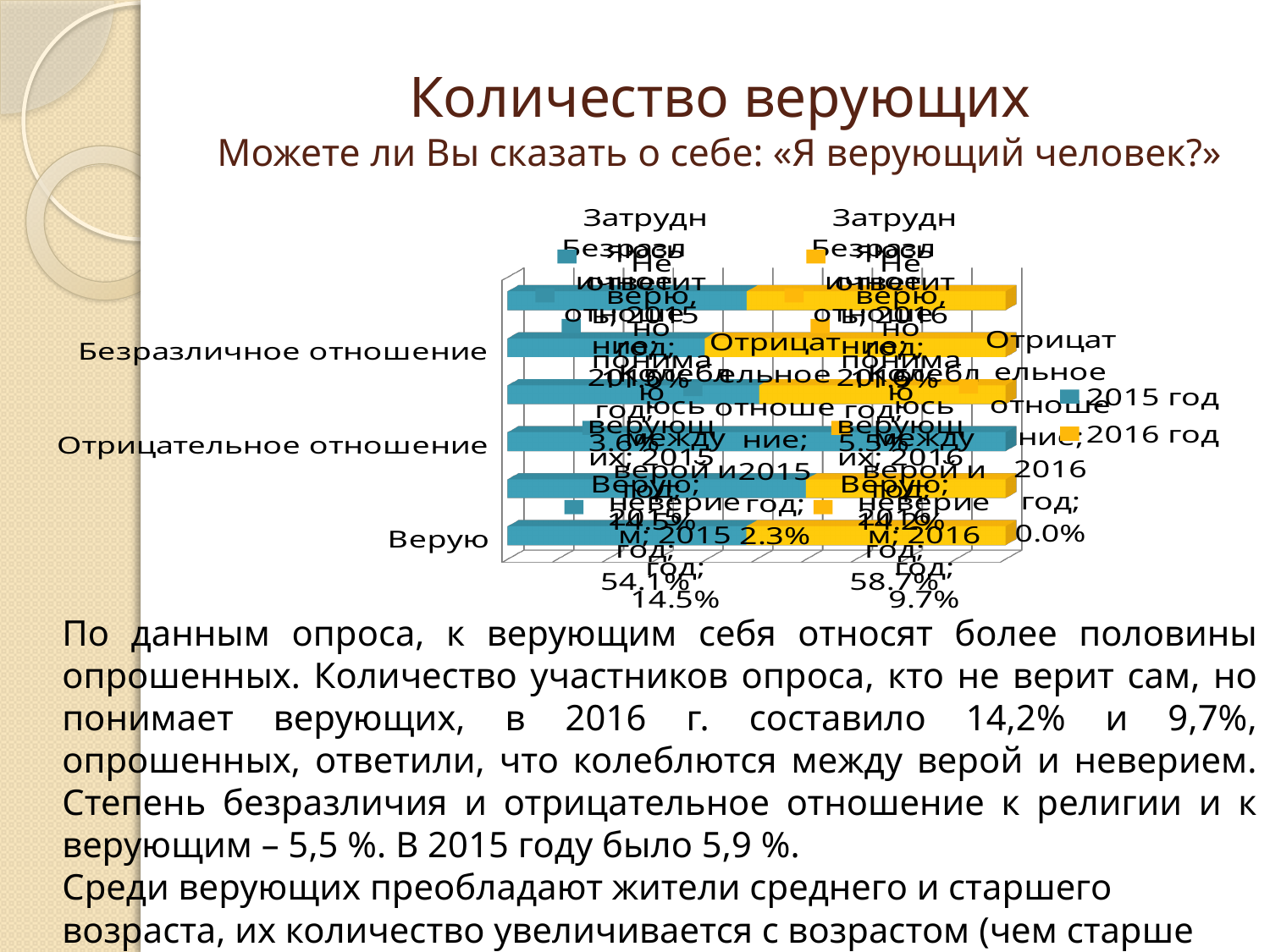
What is the value for "Верую" in 2016 год? 58.7% How many series does the chart legend list? 2 Which category has the highest values in the chart? Верую Which year has the larger value for "Верую", 2015 год or 2016 год? 2016 год What is the difference between the 2016 год and 2015 год values for "Верую"? 4.6% Which colour represents the 2016 год series in the chart? yellow What are the two series named in the chart legend? 2015 год and 2016 год What is the value for "Верую" in 2015 год? 54.1% What kind of chart is shown on the slide? bar chart